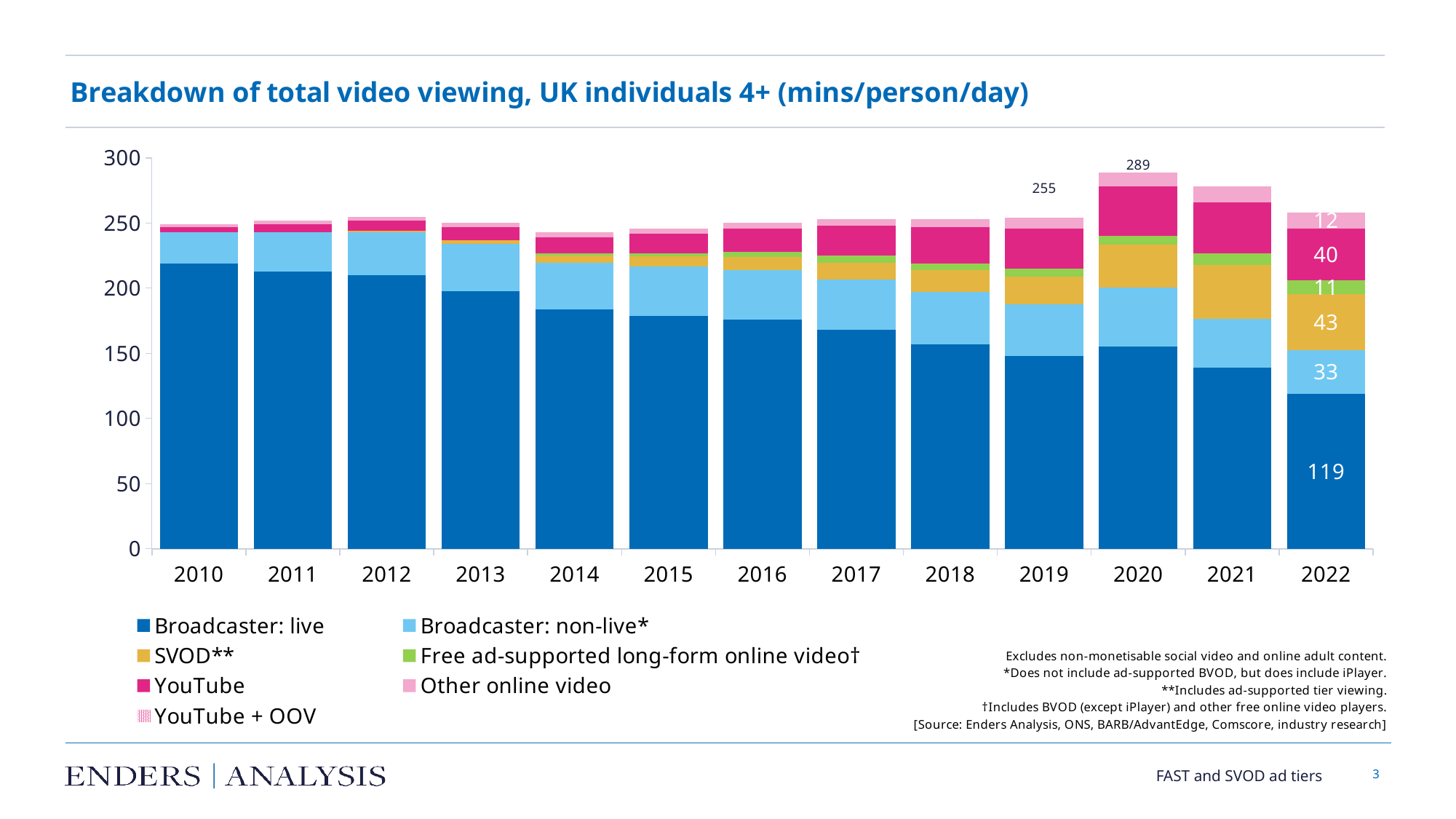
What type of chart is shown on the slide? Stacked bar chart How many series does the legend list? 7 Is the value for Broadcaster: live in 2010 greater or less than 200? greater Which year has the highest total video viewing? 2020 What is the value for YouTube in 2022? 40 What is the value for Broadcaster: live in 2022? 119 What is the value for SVOD** in 2022? 43 What is the total video viewing labelled for 2019? 255 What is the difference between the labelled totals for 2020 and 2019? 34 What is the total of the 2022 stacked bar? 258 What is the total video viewing labelled for 2020? 289 How many years are shown along the x axis? 13